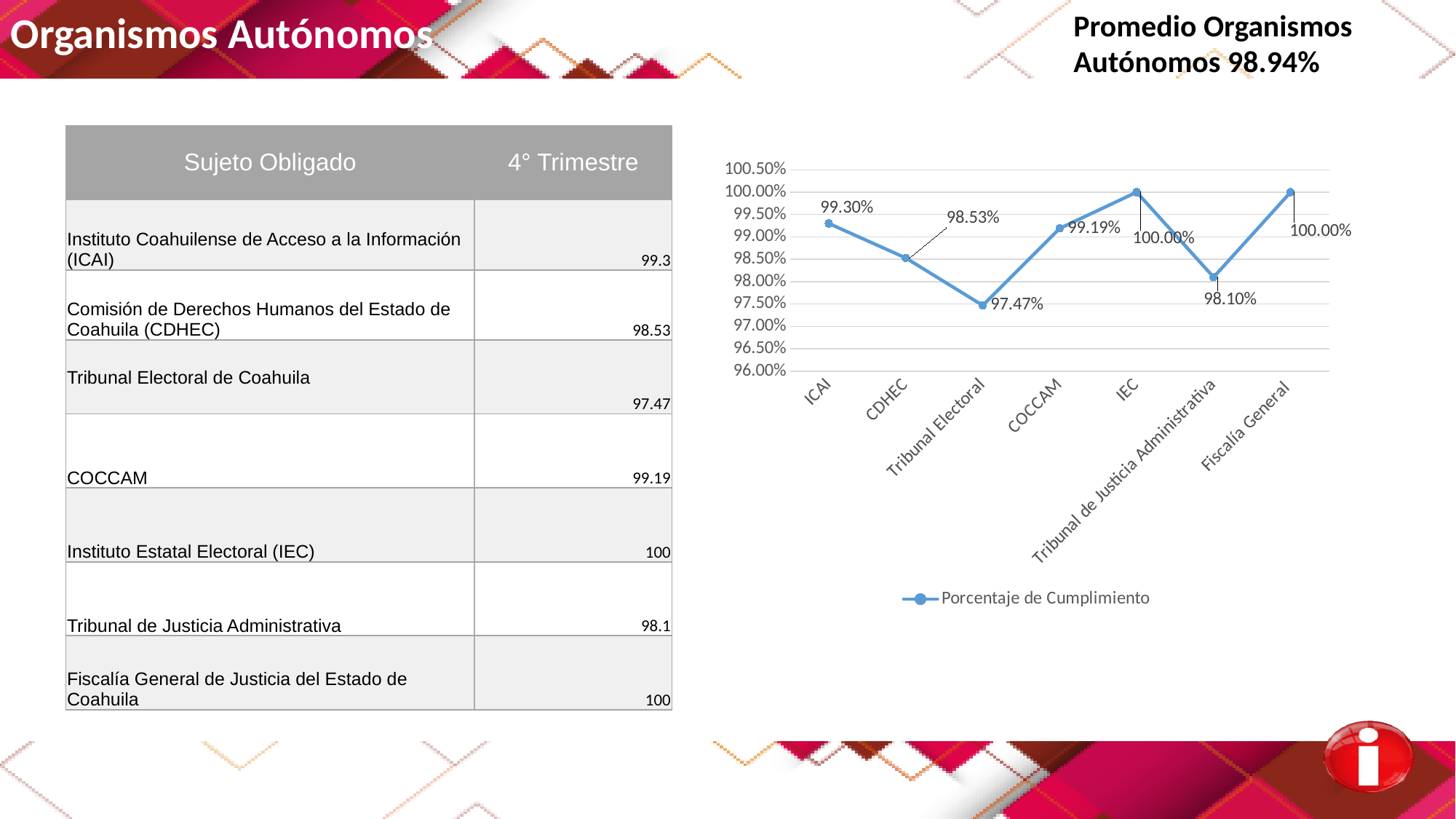
How many series does the chart legend list? 1 Which is larger, the value for CDHEC or the value for Tribunal de Justicia Administrativa? CDHEC How many categories are plotted on the x axis of the chart? 7 What is the value for CDHEC in the chart? 98.53% What is the value for COCCAM in the chart? 99.19% What is the value for Tribunal de Justicia Administrativa in the chart? 98.10% What is the name of the series shown in the chart legend? Porcentaje de Cumplimiento Which category has the lowest value in the chart? Tribunal Electoral What kind of chart is shown on the slide? Line chart Which categories share the highest value in the chart? IEC and Fiscalía General What is the value for Tribunal Electoral in the chart? 97.47% What is the difference between the values for ICAI and Tribunal Electoral? 1.83%